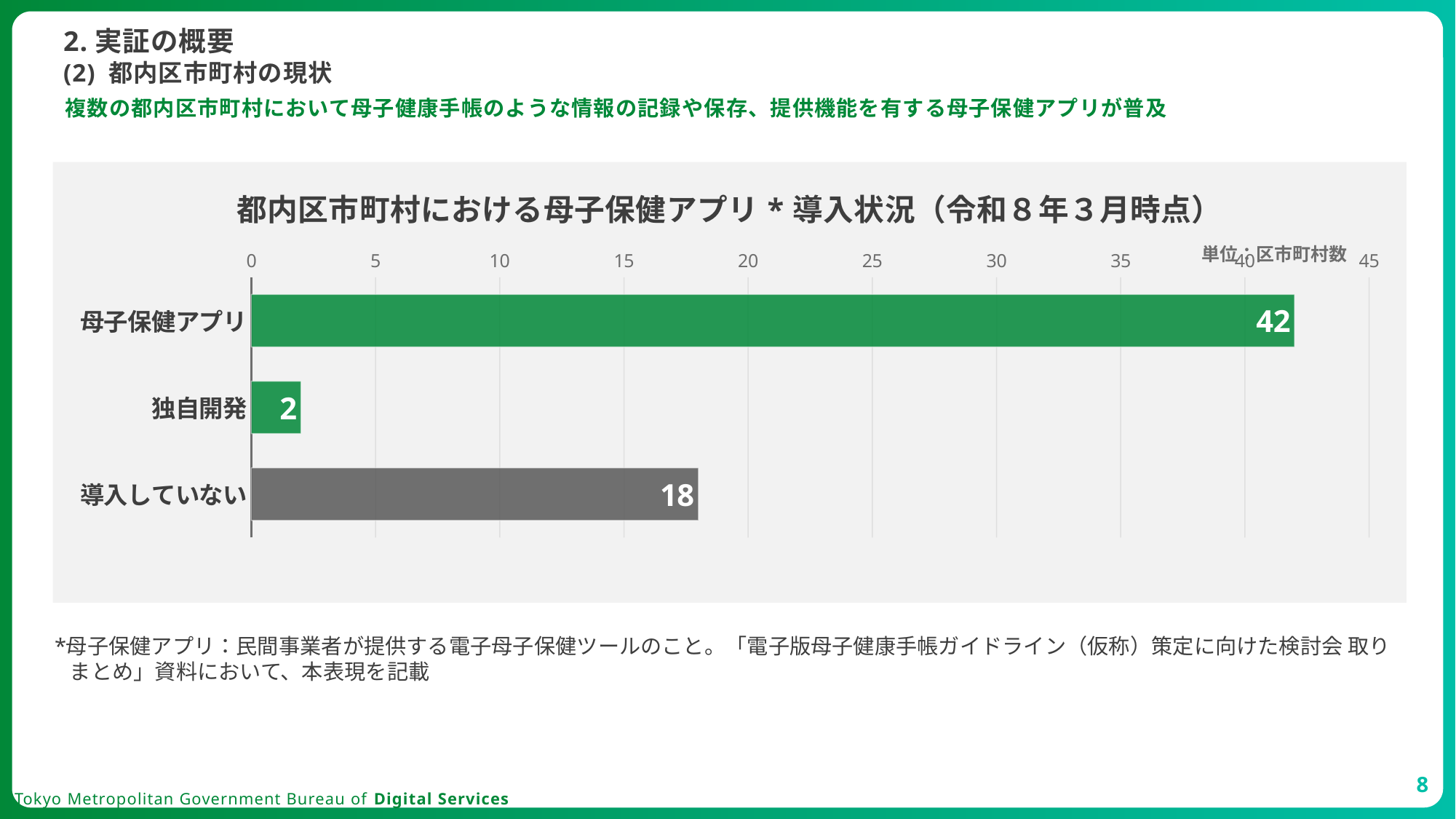
What is the title of the chart? 都内区市町村における母子保健アプリ＊導入状況（令和８年３月時点） How many categories are shown in the chart? 3 What kind of chart is shown on the slide? bar chart What is the difference between the values for 導入していない and 独自開発? 16 Which is larger, the value for 導入していない or the value for 独自開発? 導入していない Which category has the lowest value? 独自開発 What is the value for 導入していない? 18 Which category has the highest value? 母子保健アプリ What is the difference between the values for 母子保健アプリ and 導入していない? 24 What is the value for 独自開発? 2 Is the value for 母子保健アプリ greater or less than 40? greater What is the value for 母子保健アプリ? 42